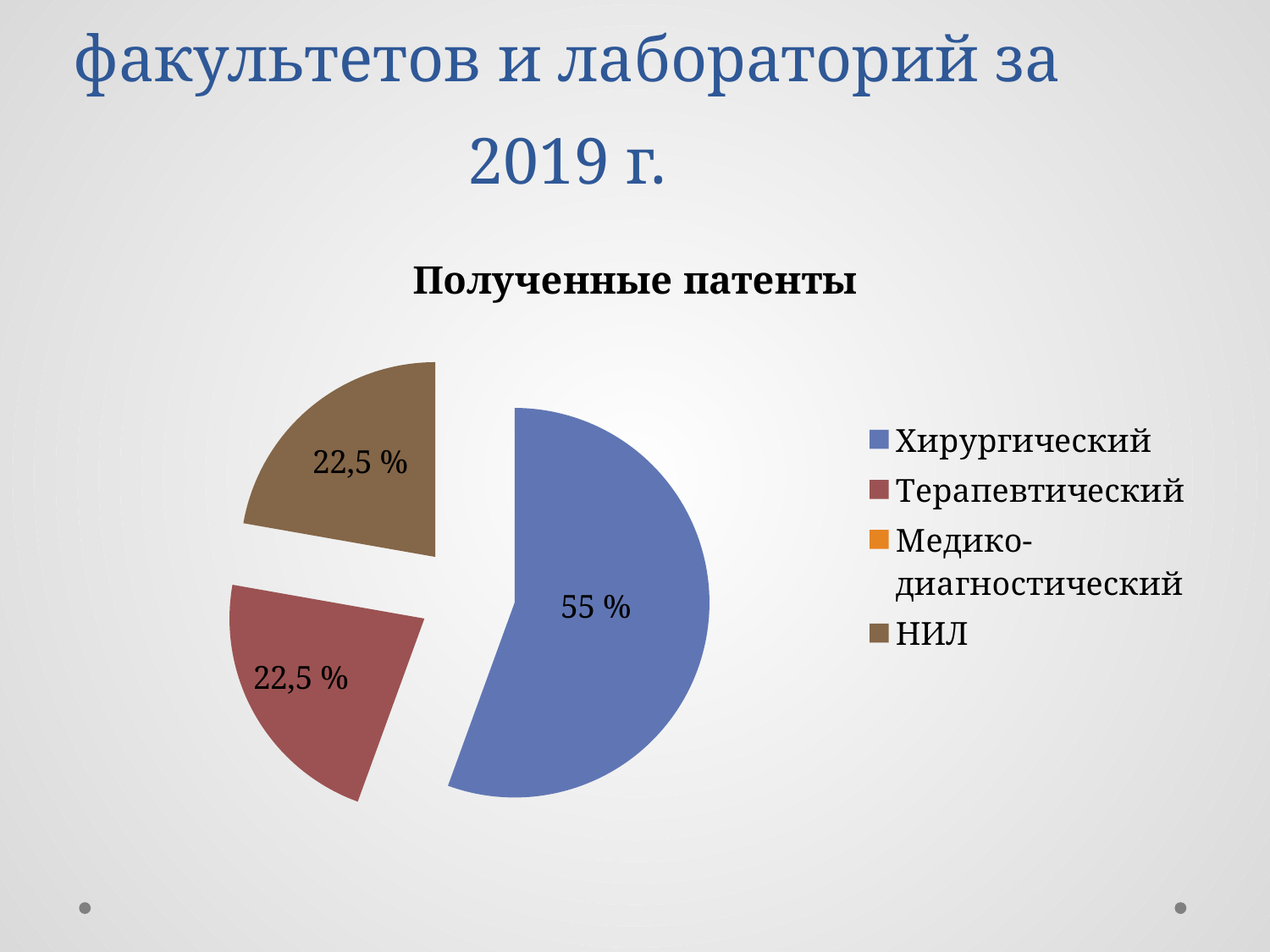
What is the combined share of Терапевтический and НИЛ in the pie chart? 45 % What value is shown for НИЛ in the pie chart? 22,5 % What kind of chart is shown on the slide? pie chart How many categories does the legend of the pie chart list? 4 What share of the pie does Хирургический have in the chart 'Полученные патенты'? 55 % What colour is the Хирургический slice in the pie chart? blue How many slices are visible in the pie chart? 3 Which is larger in the pie chart: Хирургический or НИЛ? Хирургический What is the difference between the Хирургический and Терапевтический shares in the pie chart? 32,5 % Which category has the largest slice in the pie chart? Хирургический What value is shown for Терапевтический in the pie chart? 22,5 % What is the title of the pie chart? Полученные патенты